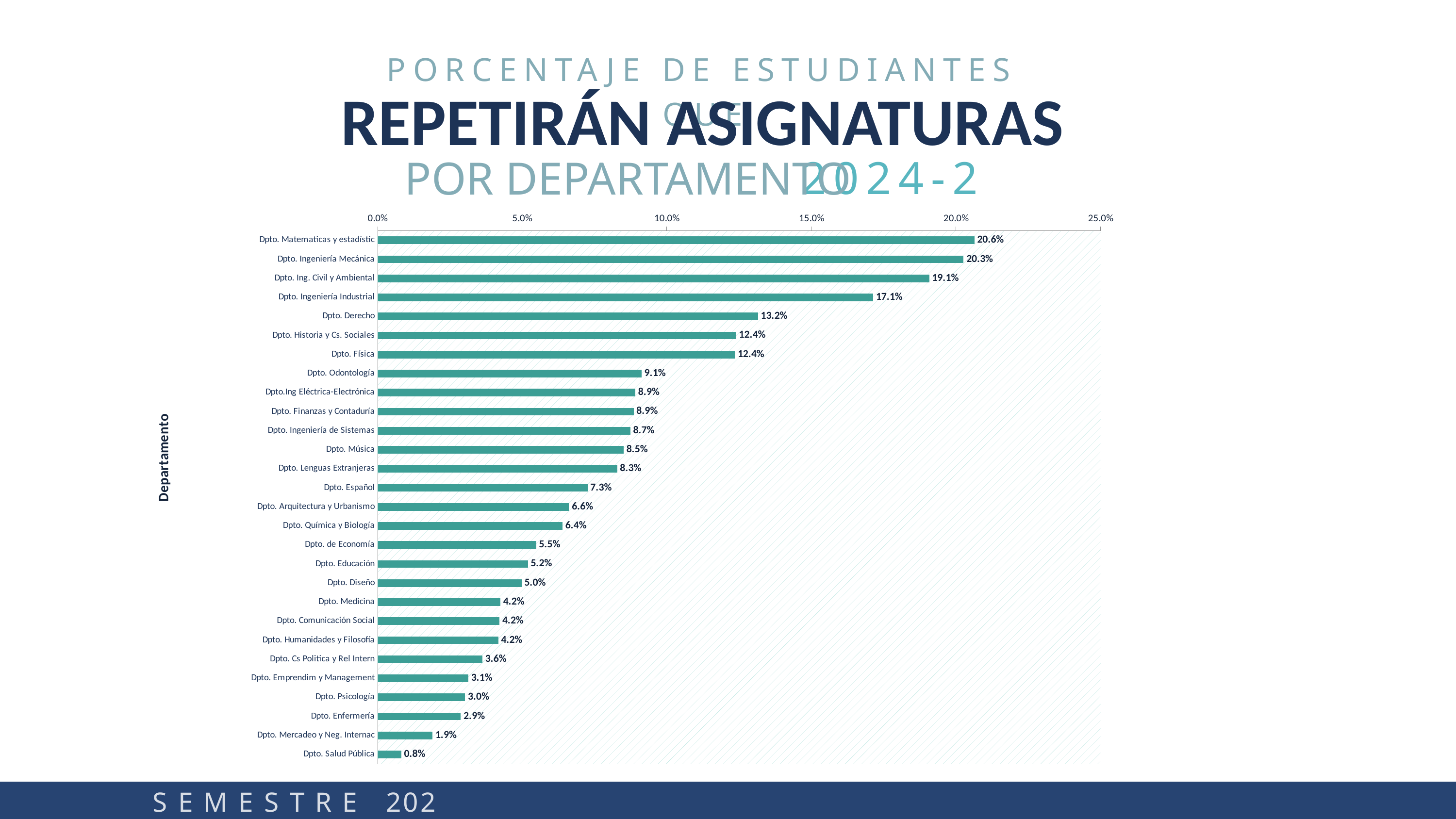
How many departments are shown in the chart? 28 What is the value for Dpto. Enfermería? 2.9% Which department has the lowest percentage? Dpto. Salud Pública What is the difference between Dpto. Ingeniería Industrial and Dpto. Derecho? 3.9% What is the label of the vertical axis? Departamento What kind of chart is shown on the slide? bar chart Which department has the highest percentage? Dpto. Matematicas y estadístic Which is larger, the value for Dpto. Odontología or the value for Dpto. Diseño? Dpto. Odontología What is the difference between Dpto. Ing. Civil y Ambiental and Dpto. Español? 11.8% What is the value for Dpto. Ingeniería de Sistemas? 8.7% Is the value for Dpto. Ingeniería Mecánica greater or less than 15.0%? greater What is the value for Dpto. Derecho? 13.2%